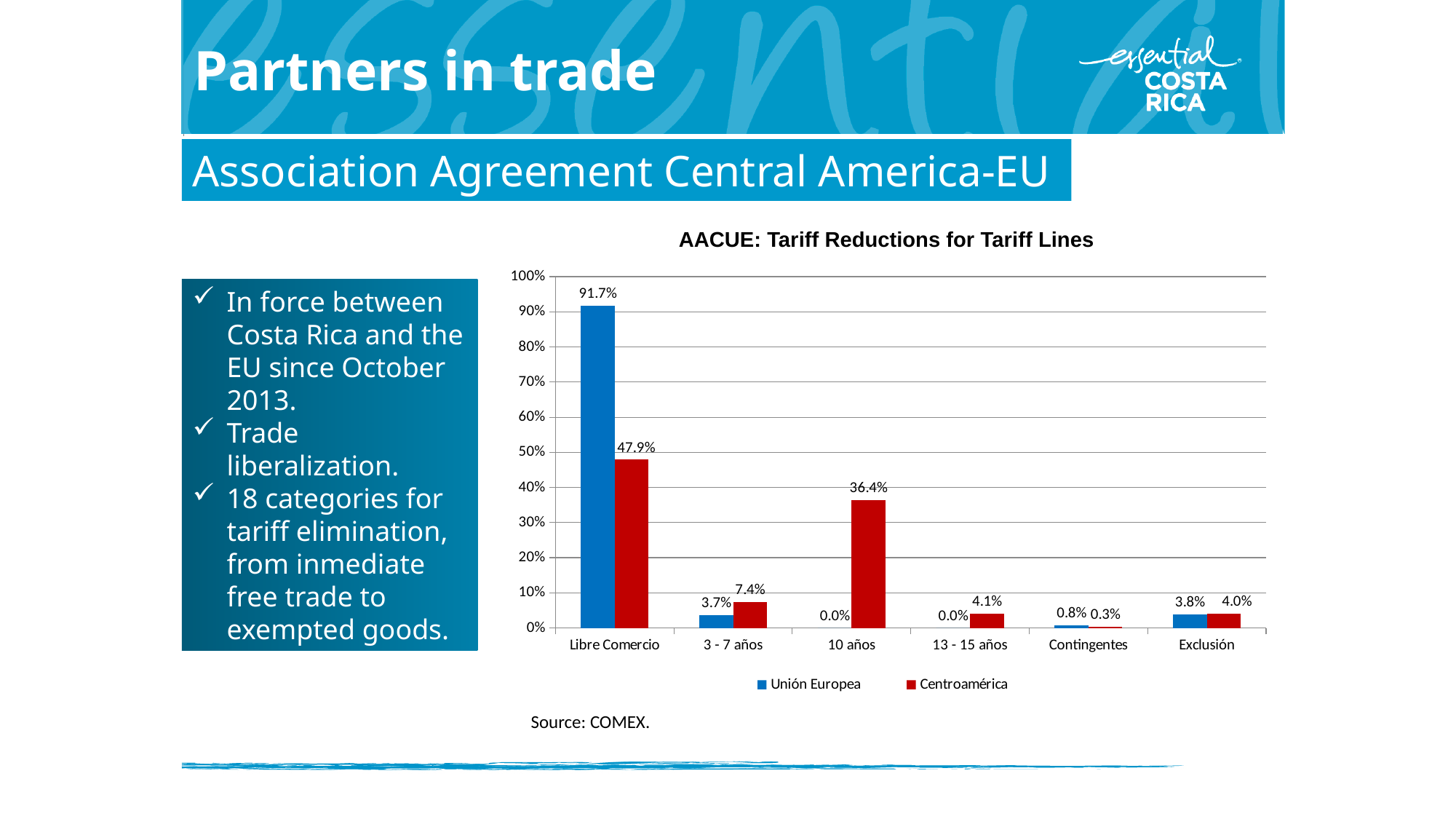
Which category has the lowest value for Centroamérica? Contingentes How many categories are shown on the x axis? 6 What is the value for Centroamérica in the 10 años category? 36.4% How many series does the legend list? 2 What is the value for Unión Europea in the Exclusión category? 3.8% Which is larger in the Exclusión category, Unión Europea or Centroamérica? Centroamérica What is the title of the chart? AACUE: Tariff Reductions for Tariff Lines What is the value for Unión Europea in the Libre Comercio category? 91.7% What kind of chart is shown on the slide? Bar chart What is the difference between the Unión Europea and Centroamérica values for Libre Comercio? 43.8% What is the value for Centroamérica in the 3 - 7 años category? 7.4% Which category has the highest value for Centroamérica? Libre Comercio